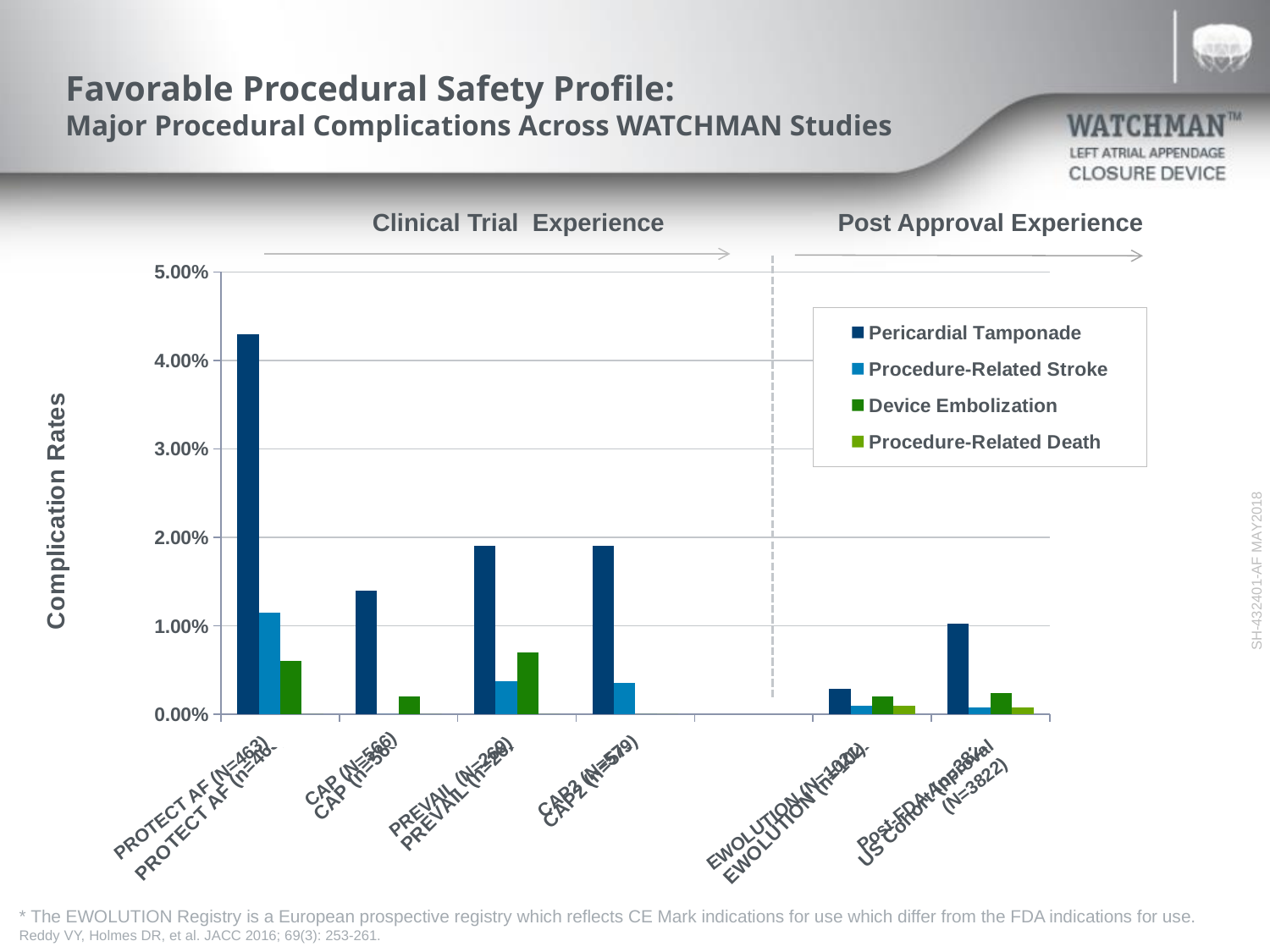
What is the title of the vertical axis? Complication Rates Is the Device Embolization rate for PREVAIL greater or less than 1.00%? less How many series does the legend list? 4 Which is larger for PROTECT AF: the Pericardial Tamponade rate or the Procedure-Related Stroke rate? Pericardial Tamponade Is the Pericardial Tamponade rate for EWOLUTION greater or less than 1.00%? less Which study has the larger Pericardial Tamponade rate, PROTECT AF or CAP? PROTECT AF Is the Pericardial Tamponade rate for PROTECT AF greater or less than 4.00%? greater How many study groups are plotted along the x axis? 6 Which study has the lowest Pericardial Tamponade rate? EWOLUTION Which study has the highest Pericardial Tamponade rate? PROTECT AF What kind of chart is shown on the slide? bar chart